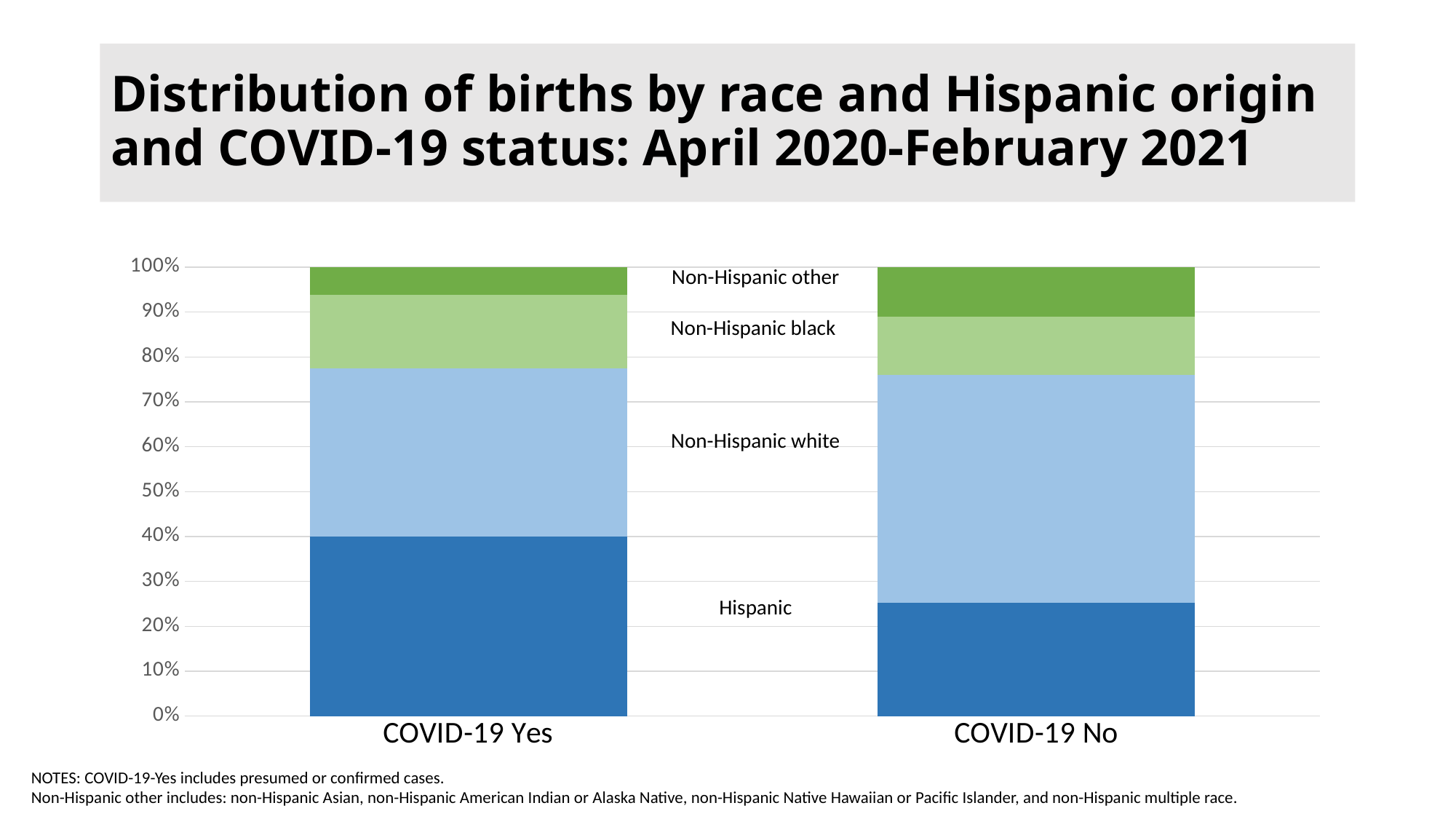
Is the Hispanic share of births for COVID-19 Yes greater or less than 30%? greater How many COVID-19 status categories are shown on the x axis? 2 Which group makes up the largest share of births in the COVID-19 Yes bar? Hispanic Is the Hispanic share of births for COVID-19 No greater or less than 30%? less What is the total of each stacked bar in the chart? 100% What kind of chart is shown on the slide? Stacked bar chart Is the Non-Hispanic other share of births larger for COVID-19 Yes or COVID-19 No? COVID-19 No Which group makes up the smallest share of births in the COVID-19 Yes bar? Non-Hispanic other Is the Non-Hispanic white share of births larger for COVID-19 Yes or COVID-19 No? COVID-19 No How many race and Hispanic origin groups are labelled in the chart? 4 Is the Hispanic share of births larger for COVID-19 Yes or COVID-19 No? COVID-19 Yes Which group makes up the largest share of births in the COVID-19 No bar? Non-Hispanic white